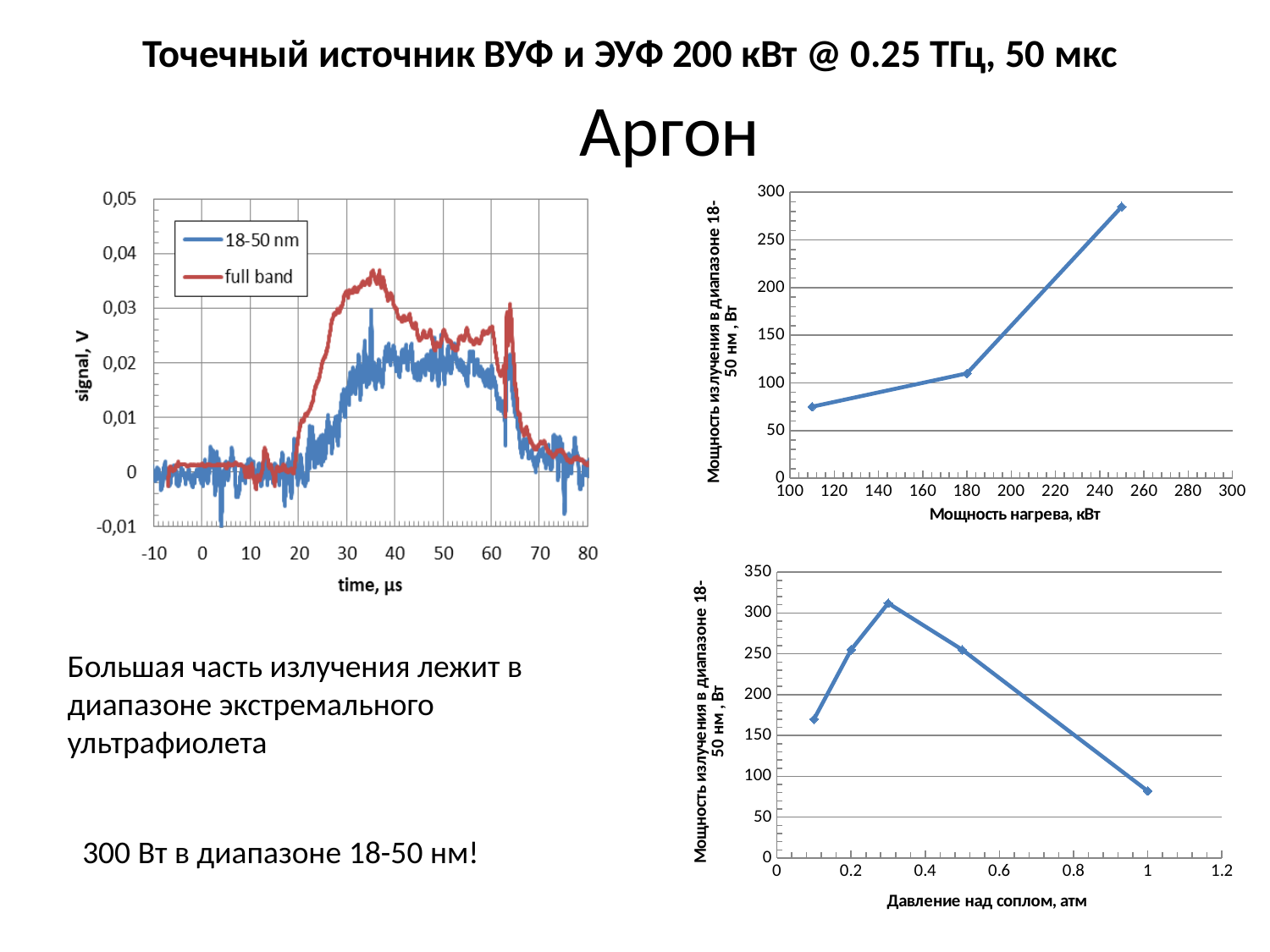
On the top-right chart, what is the x-axis label? Мощность нагрева, кВт On the top-right chart, how many data points are plotted? 3 On the bottom-right chart, at which pressure is the radiation power highest? 0.3 atm On the bottom-right chart (radiation power vs pressure above nozzle), how many data points are plotted? 5 On the top-right chart, does the radiation power rise or fall as heating power increases? rises On the left chart (signal vs time), how many series does the legend list? 2 On the bottom-right chart, at which pressure is the radiation power lowest? 1 atm What kind of chart is the top-right chart (radiation power vs heating power)? line chart On the left chart (signal vs time), what are the two legend entries? 18-50 nm and full band On the top-right chart, is the radiation power at 250 kW heating power greater or less than 250 W? greater On the top-right chart, is the radiation power at 180 kW heating power greater or less than 100 W? greater On the left chart (signal vs time), is the peak value of the full band series greater or less than 0,03 V? greater